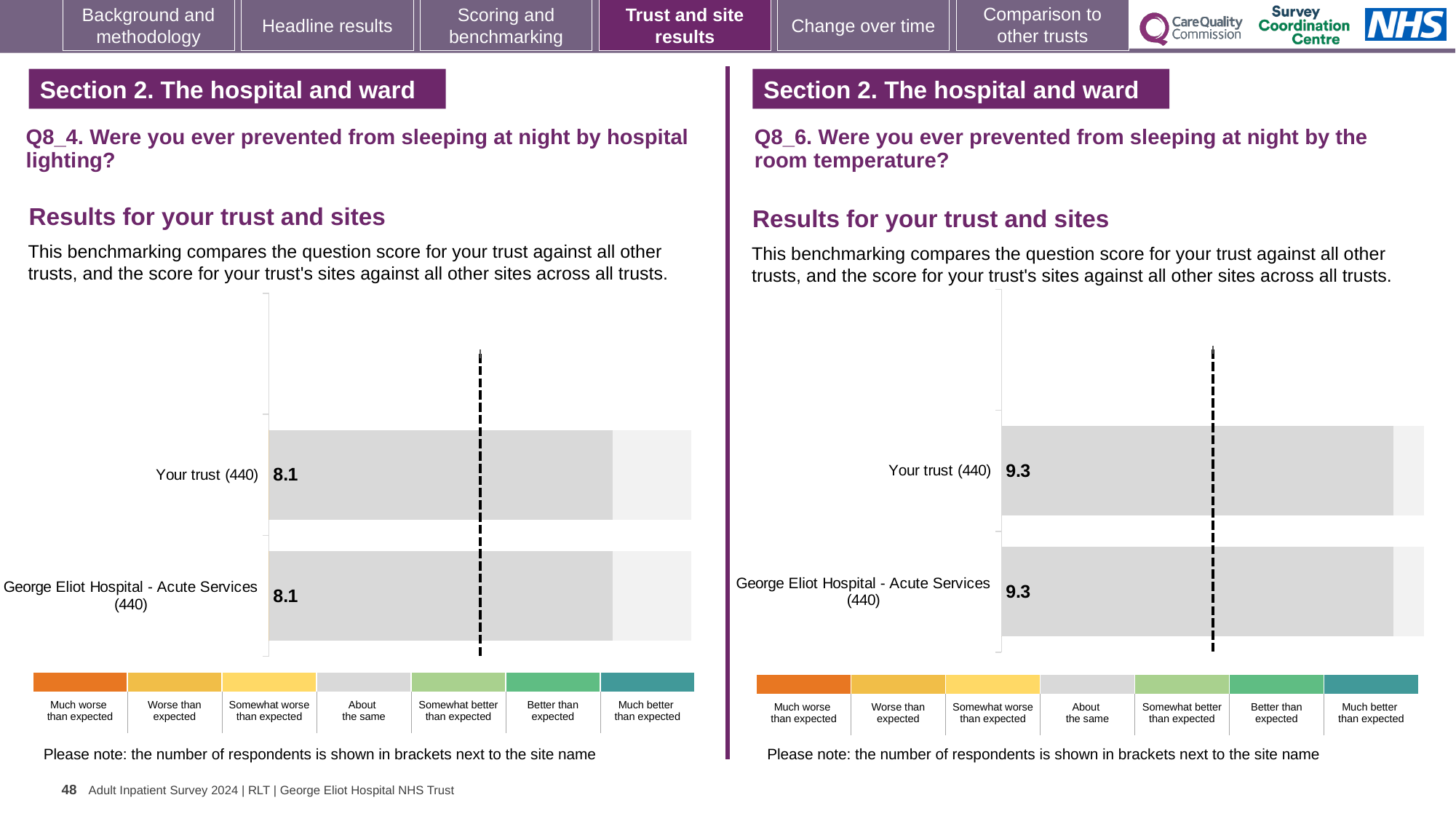
On the Q8_4 hospital lighting chart, what is the score for George Eliot Hospital - Acute Services (440)? 8.1 On the Q8_6 room temperature chart, what is the score for Your trust (440)? 9.3 How many bars are plotted on the Q8_4 hospital lighting chart? 2 How many bars are plotted on the Q8_6 room temperature chart? 2 Is the Your trust score on the Q8_6 room temperature chart higher or lower than the Your trust score on the Q8_4 hospital lighting chart? Higher How many respondents are shown in brackets next to Your trust on the Q8_4 hospital lighting chart? 440 What type of chart is used on the Q8_6 room temperature chart? Bar chart On the Q8_6 room temperature chart, what is the score for George Eliot Hospital - Acute Services (440)? 9.3 On the Q8_6 room temperature chart, what is the difference between the score for Your trust and the score for George Eliot Hospital - Acute Services? 0.0 On the Q8_4 hospital lighting chart, what is the difference between the score for Your trust and the score for George Eliot Hospital - Acute Services? 0.0 On the Q8_4 hospital lighting chart, what is the score for Your trust (440)? 8.1 How many categories does the colour legend below the Q8_4 hospital lighting chart list? 7